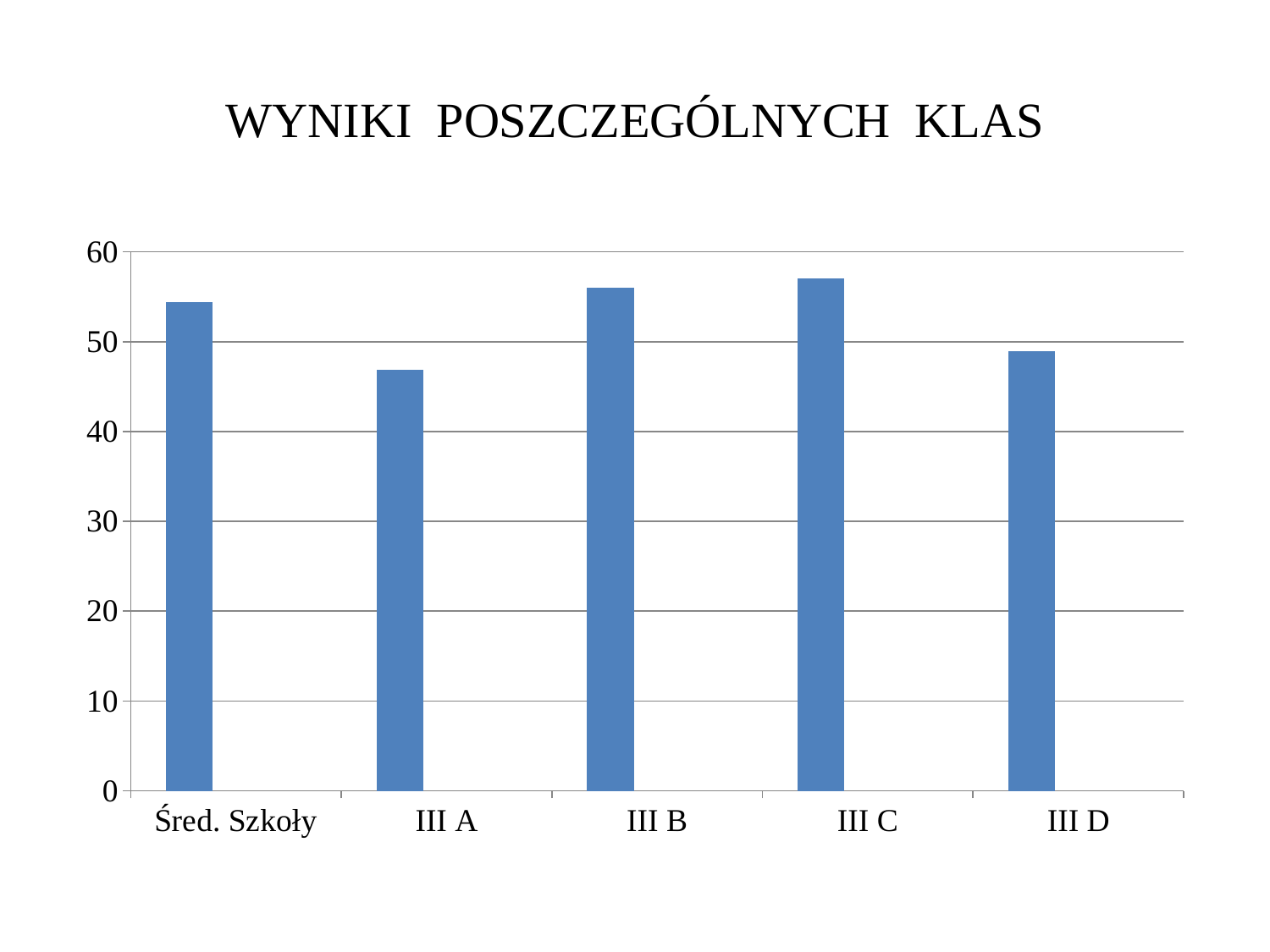
Which is larger, the value for III D or the value for Śred. Szkoły? Śred. Szkoły Which is larger, the value for III B or the value for III A? III B Is the value for III C greater or less than 60? less Is the value for III B greater or less than 50? greater Is the value for III A greater or less than 50? less What is the highest value shown on the vertical axis? 60 What is the title of the chart? WYNIKI POSZCZEGÓLNYCH KLAS What kind of chart is shown on the slide? bar chart How many categories are shown on the x axis of the chart? 5 Which category has the lowest bar? III A